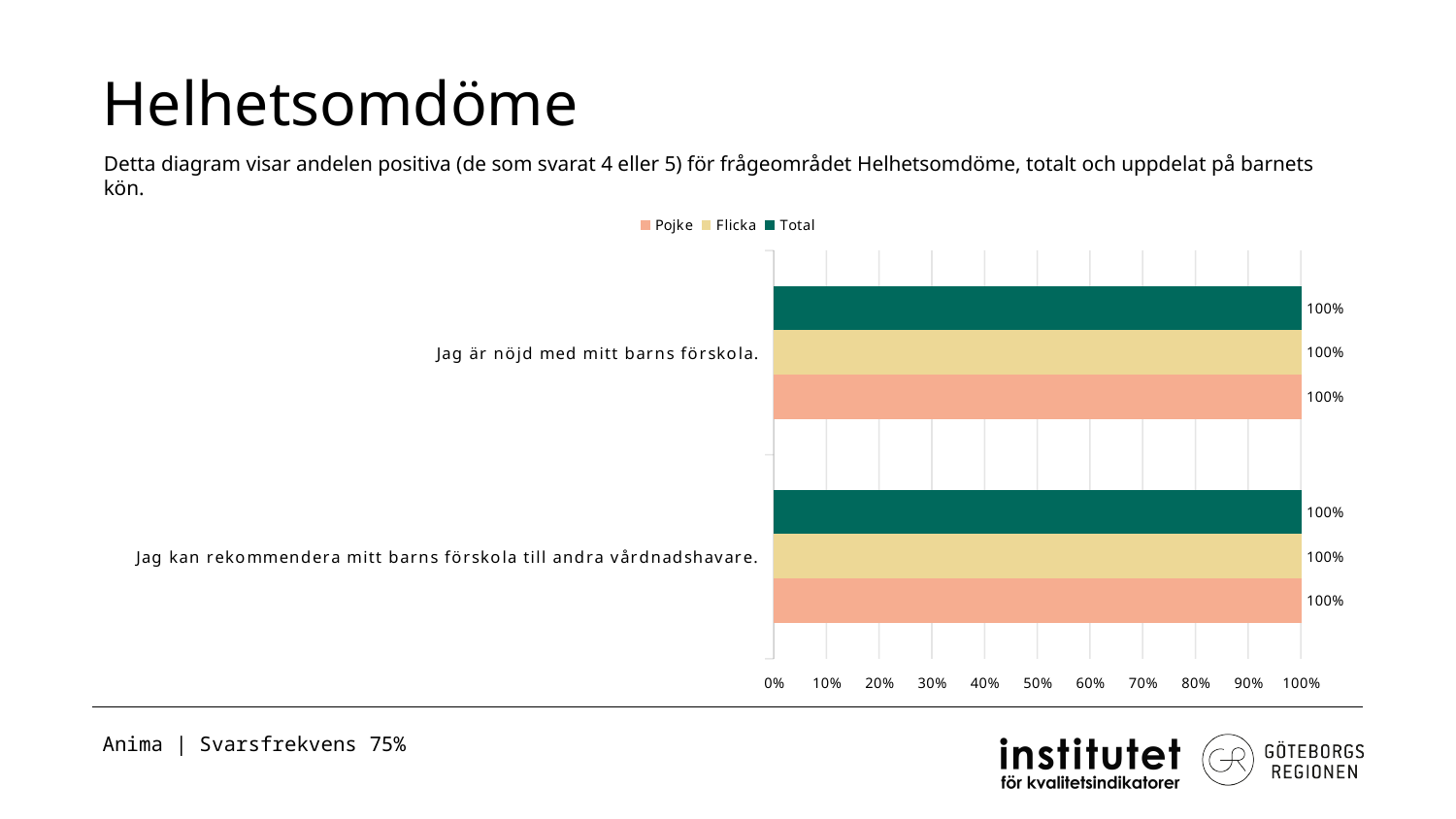
What is the value for Pojke for "Jag är nöjd med mitt barns förskola."? 100% What is the difference between the Pojke and Flicka values for "Jag är nöjd med mitt barns förskola."? 0 percentage points What is the value for Total for "Jag kan rekommendera mitt barns förskola till andra vårdnadshavare."? 100% Is the value for Pojke for "Jag kan rekommendera mitt barns förskola till andra vårdnadshavare." greater or less than 90%? greater What is the highest value shown on the x axis? 100% What kind of chart is shown on the slide? bar chart Which series is shown in dark green in the legend? Total What is the first entry listed in the chart legend? Pojke What is the value for Total for "Jag är nöjd med mitt barns förskola."? 100% How many series does the legend list? 3 What is the value for Flicka for "Jag kan rekommendera mitt barns förskola till andra vårdnadshavare."? 100% How many categories (statements) are plotted on the chart? 2